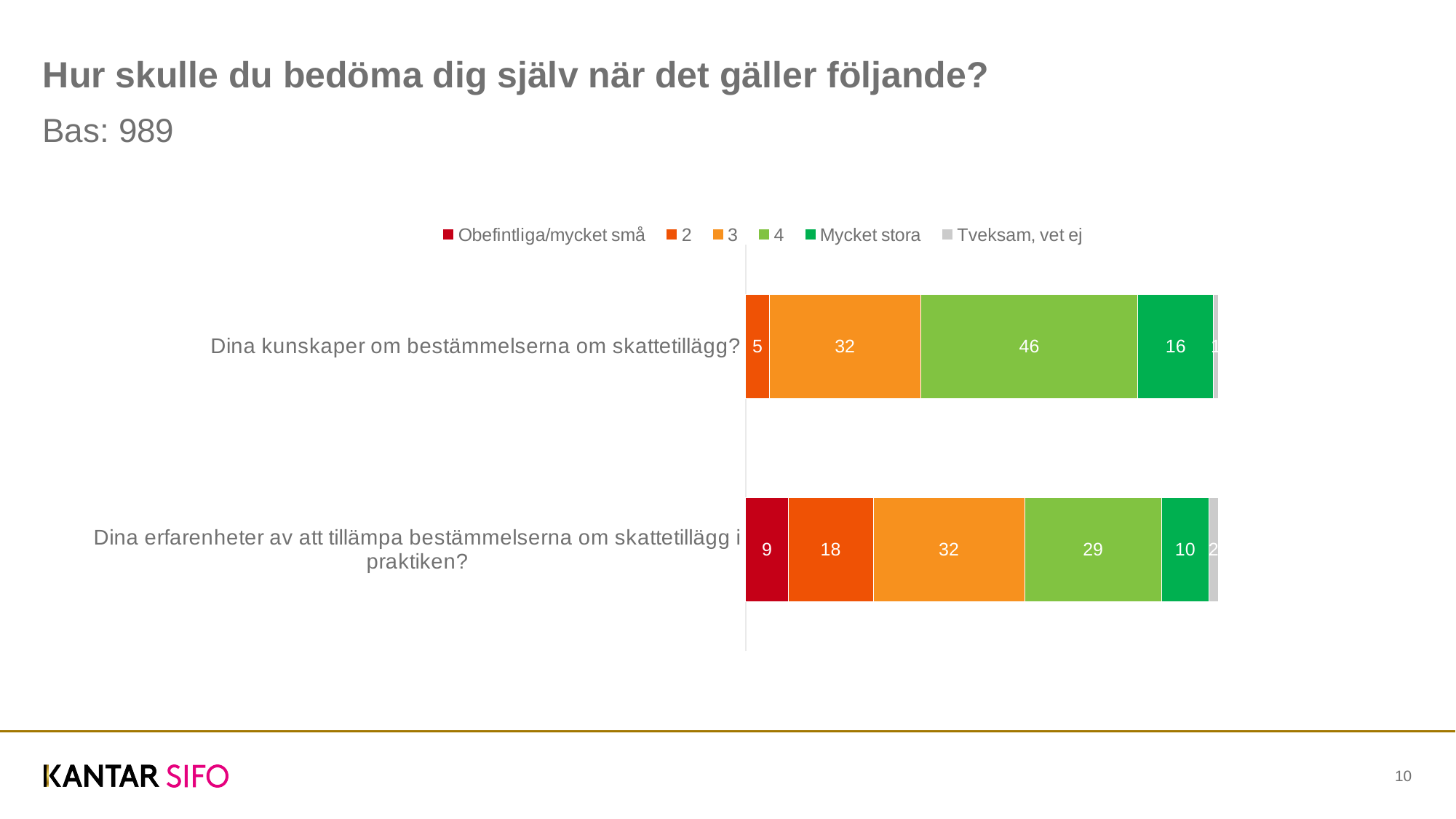
What kind of chart is shown on the slide? Stacked bar chart What is the difference between the "4" values for "Dina kunskaper om bestämmelserna om skattetillägg?" and "Dina erfarenheter av att tillämpa bestämmelserna om skattetillägg i praktiken?"? 17 How many series does the legend list? 6 What is the value for "Obefintliga/mycket små" in the bar "Dina erfarenheter av att tillämpa bestämmelserna om skattetillägg i praktiken?"? 9 Which bar has the larger value for "2": "Dina kunskaper om bestämmelserna om skattetillägg?" or "Dina erfarenheter av att tillämpa bestämmelserna om skattetillägg i praktiken?"? Dina erfarenheter av att tillämpa bestämmelserna om skattetillägg i praktiken? Which series has the largest segment in the bar "Dina kunskaper om bestämmelserna om skattetillägg?"? 4 Which series has the largest segment in the bar "Dina erfarenheter av att tillämpa bestämmelserna om skattetillägg i praktiken?"? 3 What is the value for "4" in the bar "Dina kunskaper om bestämmelserna om skattetillägg?"? 46 What is the value for "Mycket stora" in the bar "Dina kunskaper om bestämmelserna om skattetillägg?"? 16 What is the difference between the "Mycket stora" values for the two bars? 6 What is the value for "3" in the bar "Dina erfarenheter av att tillämpa bestämmelserna om skattetillägg i praktiken?"? 32 How many bars (categories) does the chart show? 2